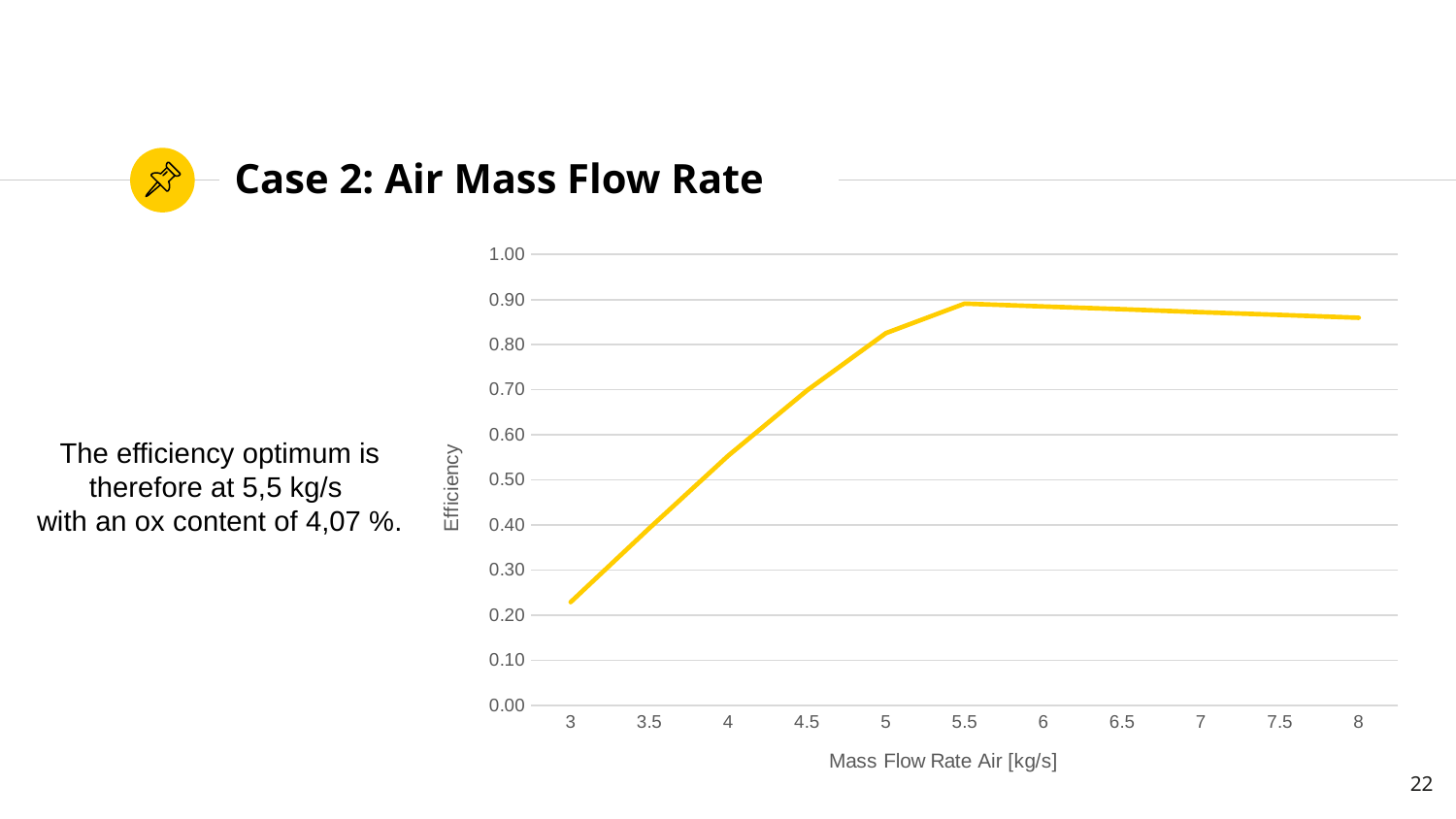
What is the label of the x axis of the chart? Mass Flow Rate Air [kg/s] What kind of chart is shown on the slide? line chart What is the label of the y axis of the chart? Efficiency Which has the higher efficiency: a mass flow rate of 5.5 kg/s or 8 kg/s? 5.5 kg/s Is the efficiency at a mass flow rate of 5 kg/s greater or less than 0.70? greater Does the efficiency rise or fall as the mass flow rate increases from 3 to 5.5 kg/s? rise At which mass flow rate of air is the efficiency highest? 5.5 Which has the higher efficiency: a mass flow rate of 3 kg/s or 8 kg/s? 8 kg/s Is the efficiency at a mass flow rate of 3 kg/s greater or less than 0.30? less Is the efficiency at a mass flow rate of 5.5 kg/s greater or less than 0.80? greater At which mass flow rate of air is the efficiency lowest? 3